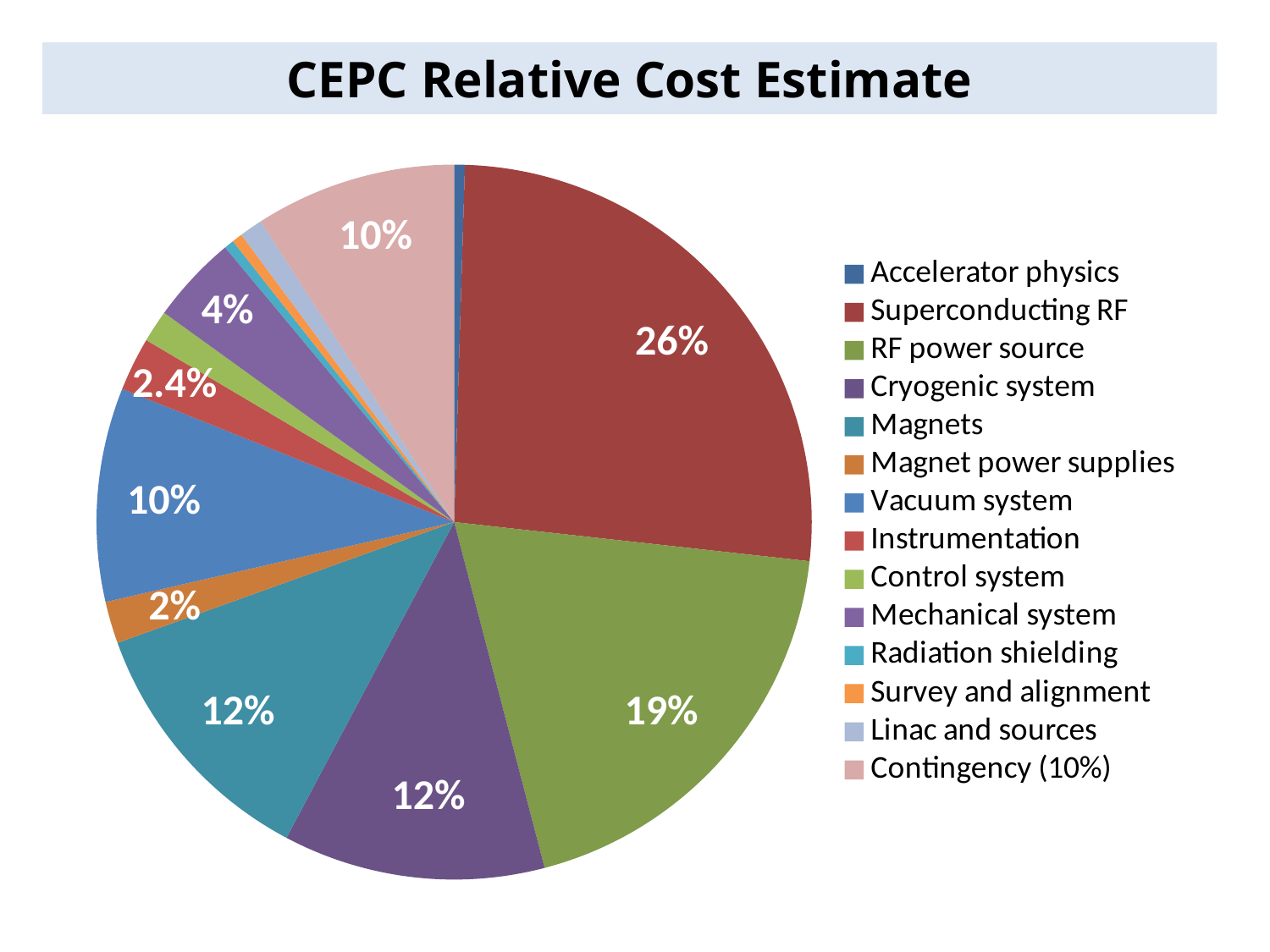
How many categories are listed in the legend? 14 What type of chart is shown on the slide? Pie chart By how many percentage points does Superconducting RF exceed RF power source? 7 percentage points What share of the pie does Superconducting RF account for? 26% Which is larger, the RF power source slice or the Cryogenic system slice? RF power source What is the value labelled for the Vacuum system slice? 10% What share does Mechanical system have? 4% Which category has the largest slice of the pie? Superconducting RF What percentage is shown for Instrumentation? 2.4% What percentage is labelled for Magnet power supplies? 2% What is the title of the chart? CEPC Relative Cost Estimate What percentage is shown for RF power source? 19%